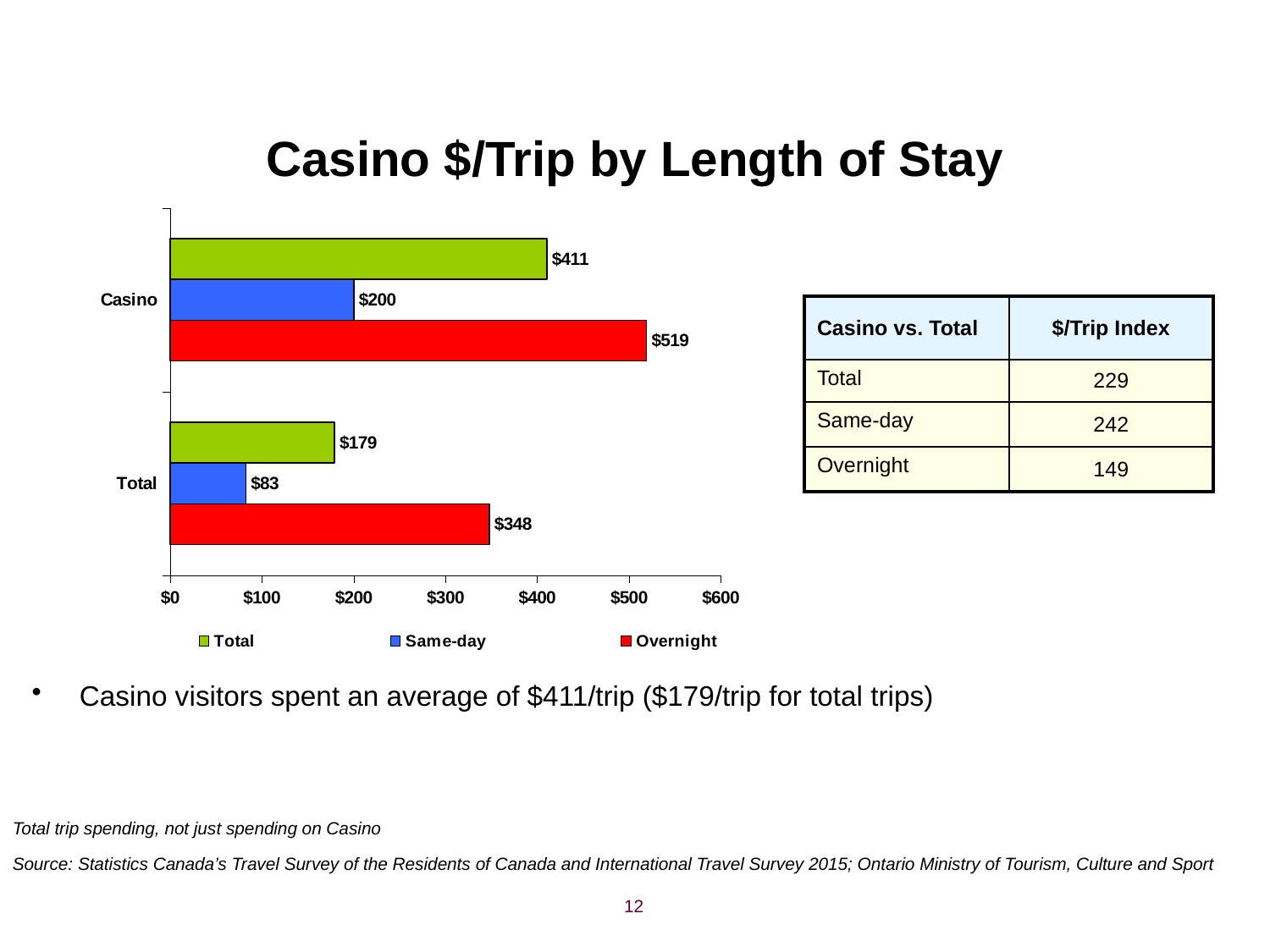
What kind of chart is shown on the slide? Bar chart Which series has the lowest value for the Total category? Same-day Which series has the highest value for the Casino category? Overnight What is the Overnight $/trip value for Casino? $519 What is the difference between the Overnight values for Casino and Total? $171 What is the difference between the Same-day values for Casino and Total? $117 What is the Total series value for Casino? $411 What is the Same-day $/trip value for Total? $83 Which is larger: the Total series value for Casino or the Overnight value for Total? Total series value for Casino How many categories are shown on the chart? 2 What is the title of the chart? Casino $/Trip by Length of Stay How many series does the legend list? 3